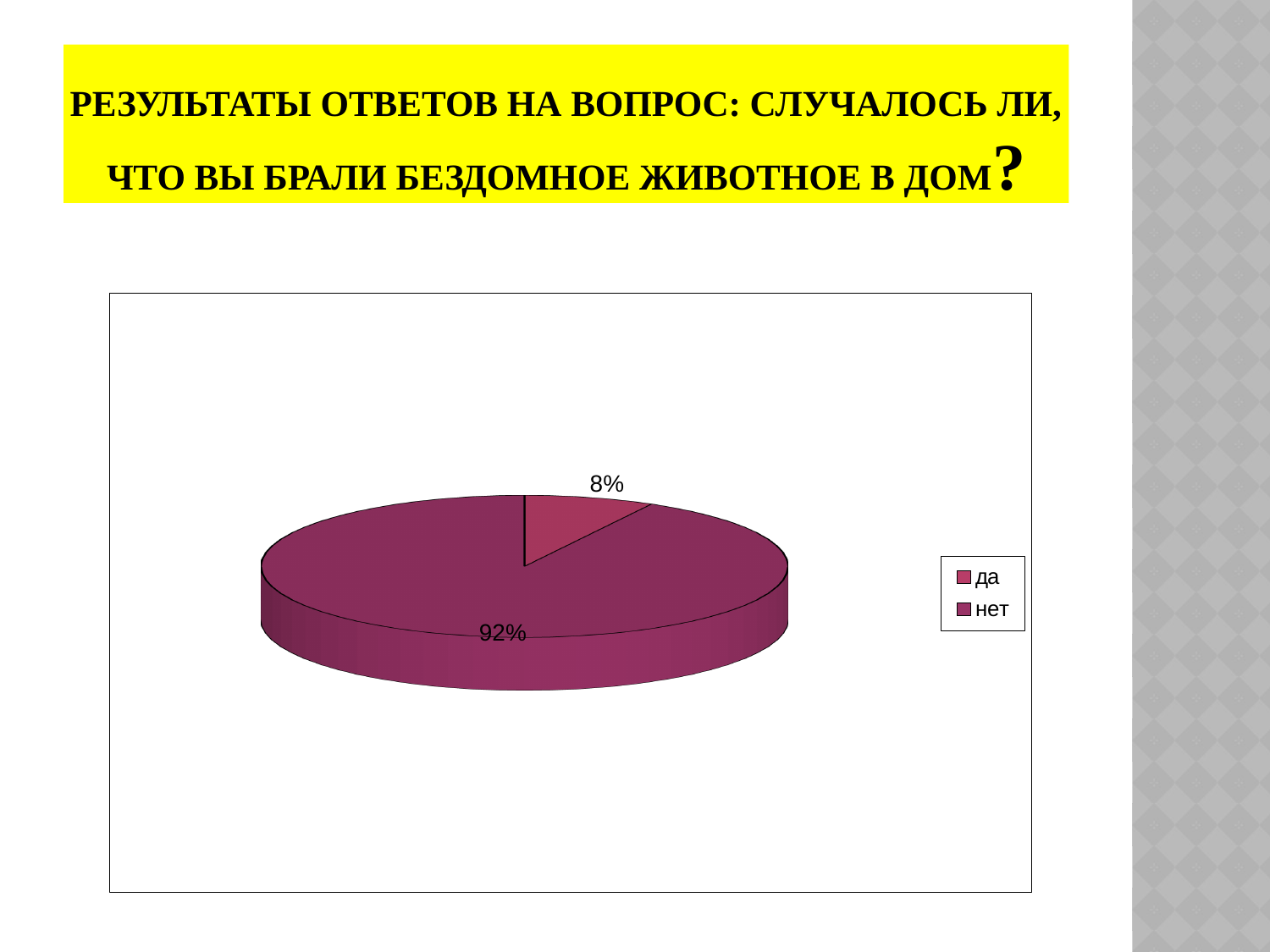
Which category has the largest slice of the pie? нет Which category has the smallest slice of the pie? да How many slices does the pie chart have? 2 What share of the pie does "да" represent? 8% Is the value for "да" greater or less than 10%? less What is the difference in percentage points between the "нет" and "да" slices? 84 What are the two legend entries of the pie chart? да, нет Is the value for "нет" greater or less than 50%? greater How many entries does the legend list? 2 What kind of chart is shown on the slide? pie chart What share of the pie does "нет" represent? 92% Which is larger, the slice for "да" or the slice for "нет"? нет